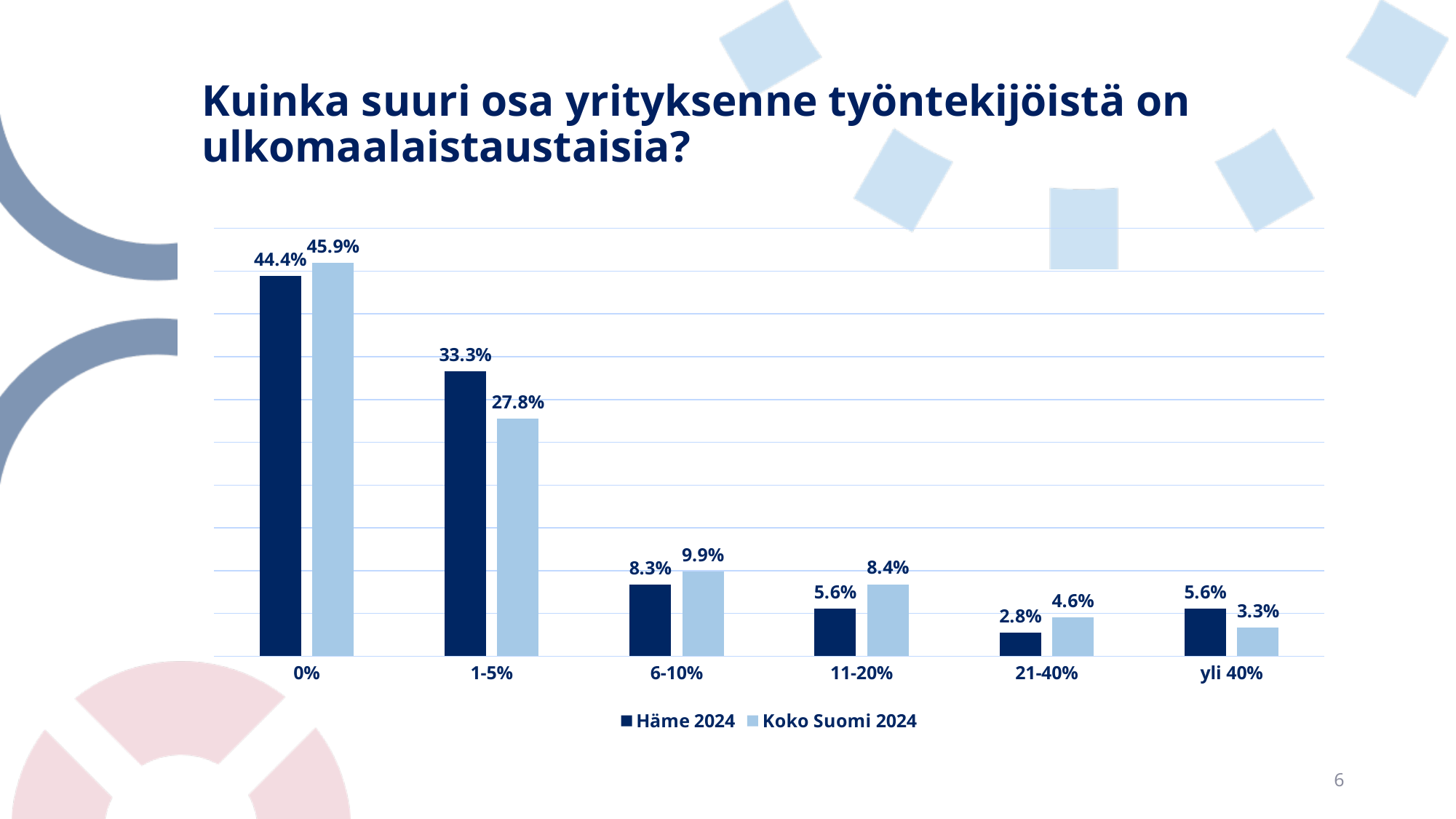
How many series does the legend list? 2 What is the value for Koko Suomi 2024 in the 1-5% category? 27.8% What is the value for Häme 2024 in the 0% category? 44.4% What kind of chart is shown on the slide? Bar chart How many categories are shown on the x axis? 6 In the 6-10% category, which series has the larger value, Häme 2024 or Koko Suomi 2024? Koko Suomi 2024 What is the difference between Häme 2024 and Koko Suomi 2024 in the 1-5% category? 5.5% What is the value for Koko Suomi 2024 in the 21-40% category? 4.6% Which category has the lowest value for Häme 2024? 21-40% Which category has the highest value for Koko Suomi 2024? 0% What are the two series named in the legend? Häme 2024 and Koko Suomi 2024 What is the value for Häme 2024 in the yli 40% category? 5.6%